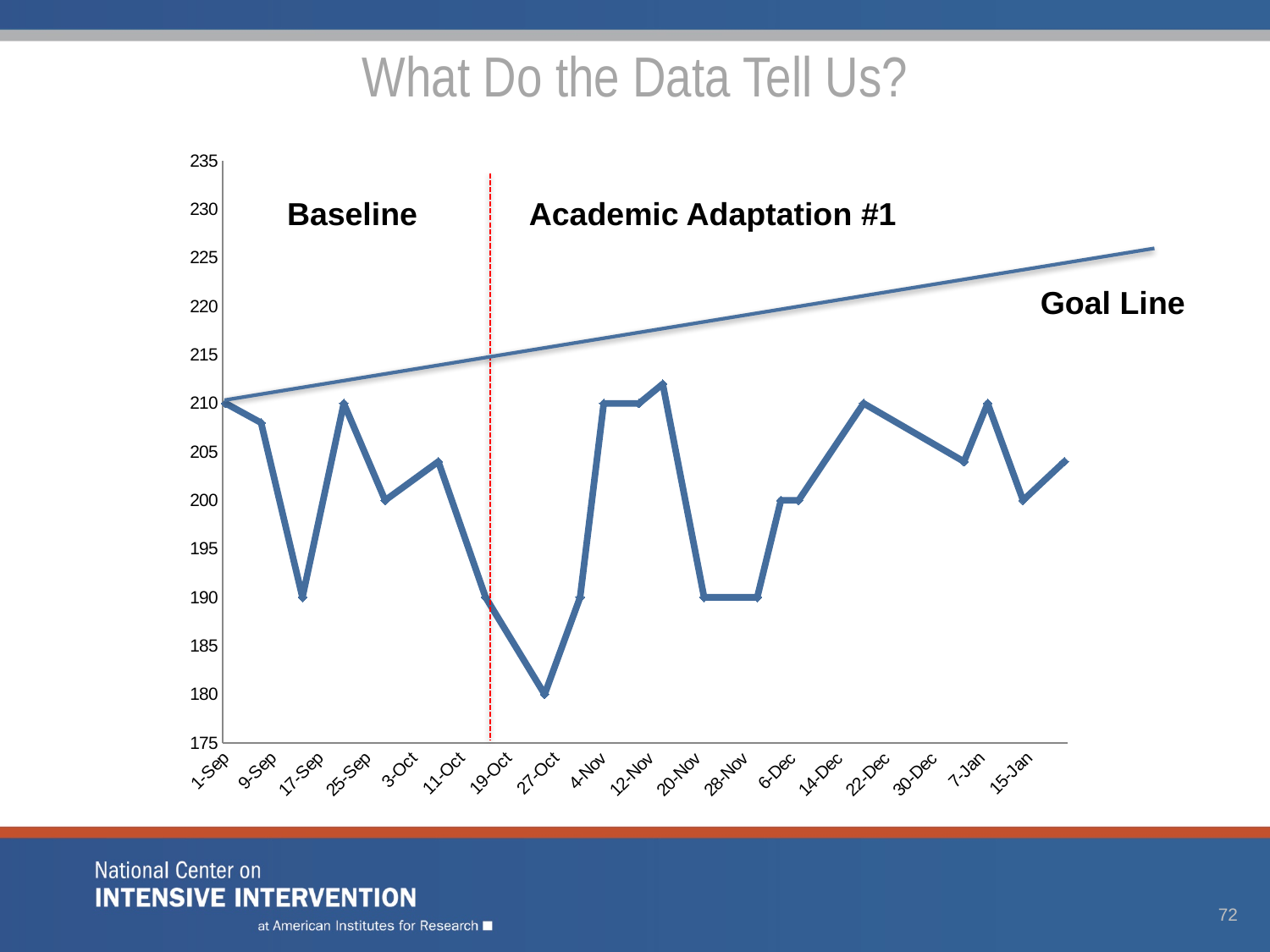
At which date does the data line reach its lowest value? 27-Oct Does the Goal Line rise or fall from left to right? rises Which is larger, the value at 1-Sep or the value at 27-Oct? 1-Sep What is the value of the data point at 27-Oct? 180 Is the value for 27-Oct greater or less than 185? less What is the difference between the value at 1-Sep and the value at 27-Oct? 30 What kind of chart is shown on the slide? line chart What is the value of the data point at 17-Sep? 190 What are the two phase labels shown above the data in the chart? Baseline and Academic Adaptation #1 What is the highest value shown on the y axis? 235 What is the value of the data point at 1-Sep? 210